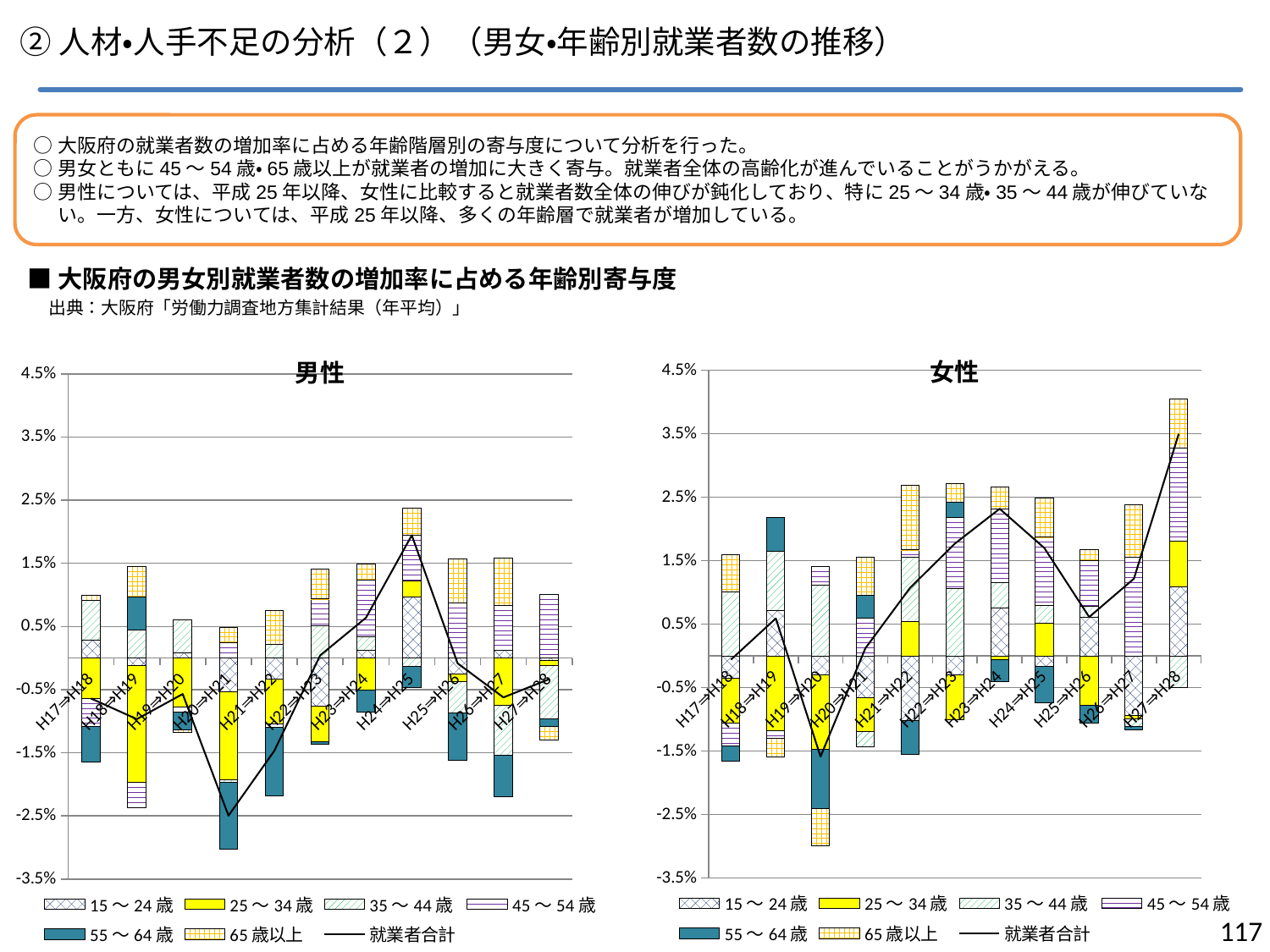
What kind of chart is the 男性 chart? stacked bar chart with a line In the 男性 chart, does the 就業者合計 line rise or fall from H20⇒H21 to H24⇒H25? rise In the 男性 chart, at which category does the 就業者合計 line reach its lowest point? H20⇒H21 In the 女性 chart, at which category does the 就業者合計 line reach its highest point? H27⇒H28 How many categories are shown on the x axis of the 女性 chart? 11 In the 男性 chart, at which category does the 就業者合計 line reach its highest point? H24⇒H25 In the 男性 chart, is the 就業者合計 value for H17⇒H18 greater or less than -0.5%? less How many series does the legend of the 男性 chart list? 7 For H27⇒H28, which chart shows the larger 就業者合計 value, 男性 or 女性? 女性 In the 男性 chart, is the 就業者合計 value for H24⇒H25 greater or less than 1.5%? greater In the 女性 chart, at which category does the 就業者合計 line reach its lowest point? H19⇒H20 In the 女性 chart, is the 就業者合計 value for H23⇒H24 greater or less than 1.5%? greater